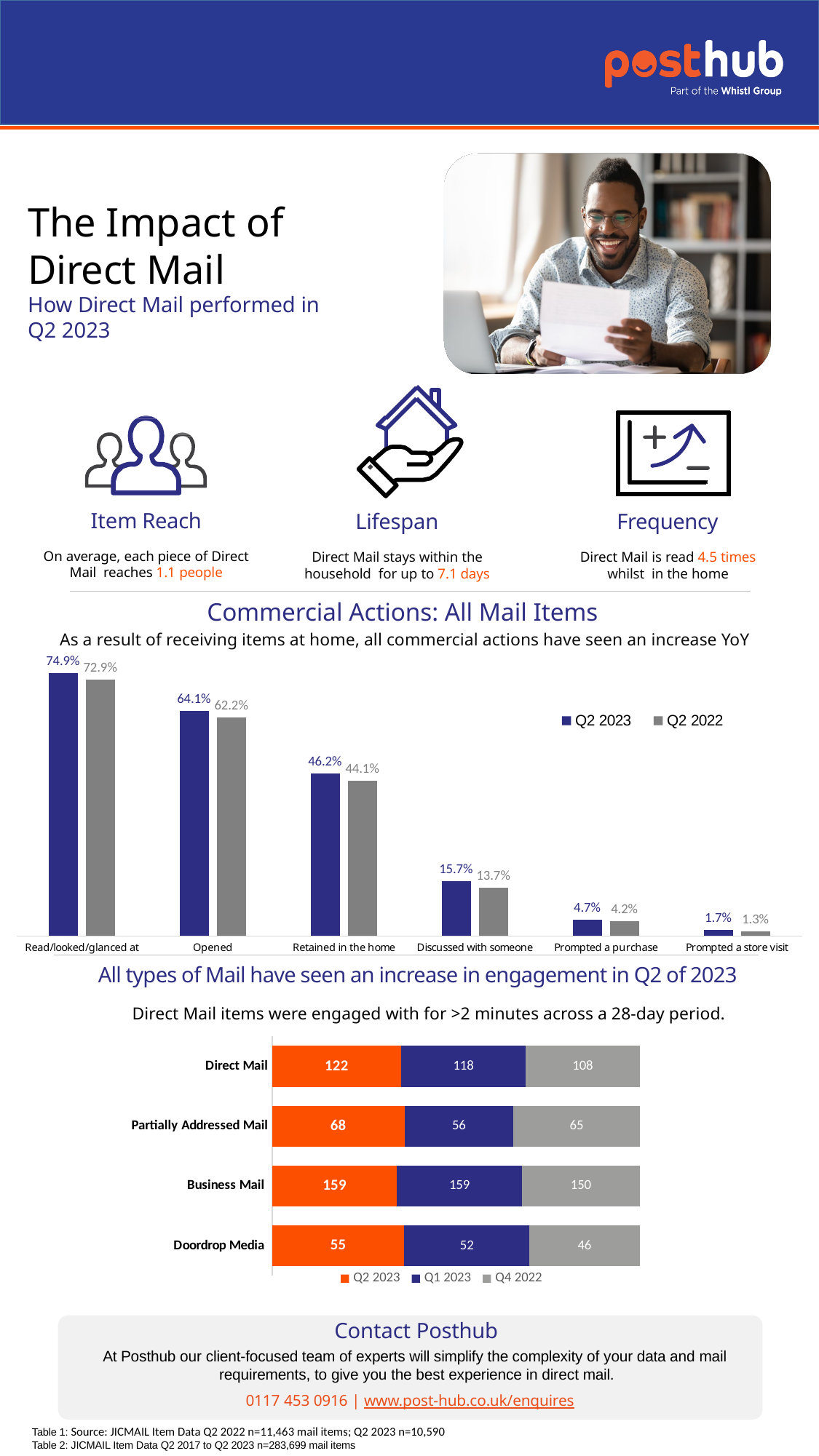
What kind of chart is the one below the heading 'All types of Mail have seen an increase in engagement in Q2 of 2023'? Stacked bar chart In the stacked bar chart below the heading 'All types of Mail have seen an increase in engagement in Q2 of 2023', what is the total of the Doordrop Media bar? 153 In the Commercial Actions: All Mail Items chart, what is the Q2 2022 value for Discussed with someone? 13.7% In the Commercial Actions: All Mail Items chart, what is the difference between the Q2 2023 and Q2 2022 values for Retained in the home? 2.1% In the Commercial Actions: All Mail Items chart, how many series does the legend list? 2 In the stacked bar chart below the heading 'All types of Mail have seen an increase in engagement in Q2 of 2023', which is larger: the Q2 2023 value for Direct Mail or the Q2 2023 value for Business Mail? Business Mail In the stacked bar chart below the heading 'All types of Mail have seen an increase in engagement in Q2 of 2023', what is the Q1 2023 value for Partially Addressed Mail? 56 In the Commercial Actions: All Mail Items chart, do the Q2 2023 values rise or fall from left to right along the x axis? fall In the Commercial Actions: All Mail Items chart, which category has the lowest Q2 2022 value? Prompted a store visit In the Commercial Actions: All Mail Items chart, which category has the highest Q2 2023 value? Read/looked/glanced at In the Commercial Actions: All Mail Items chart, what is the Q2 2023 value for Opened? 64.1% In the Commercial Actions: All Mail Items chart, how many categories are shown on the x axis? 6